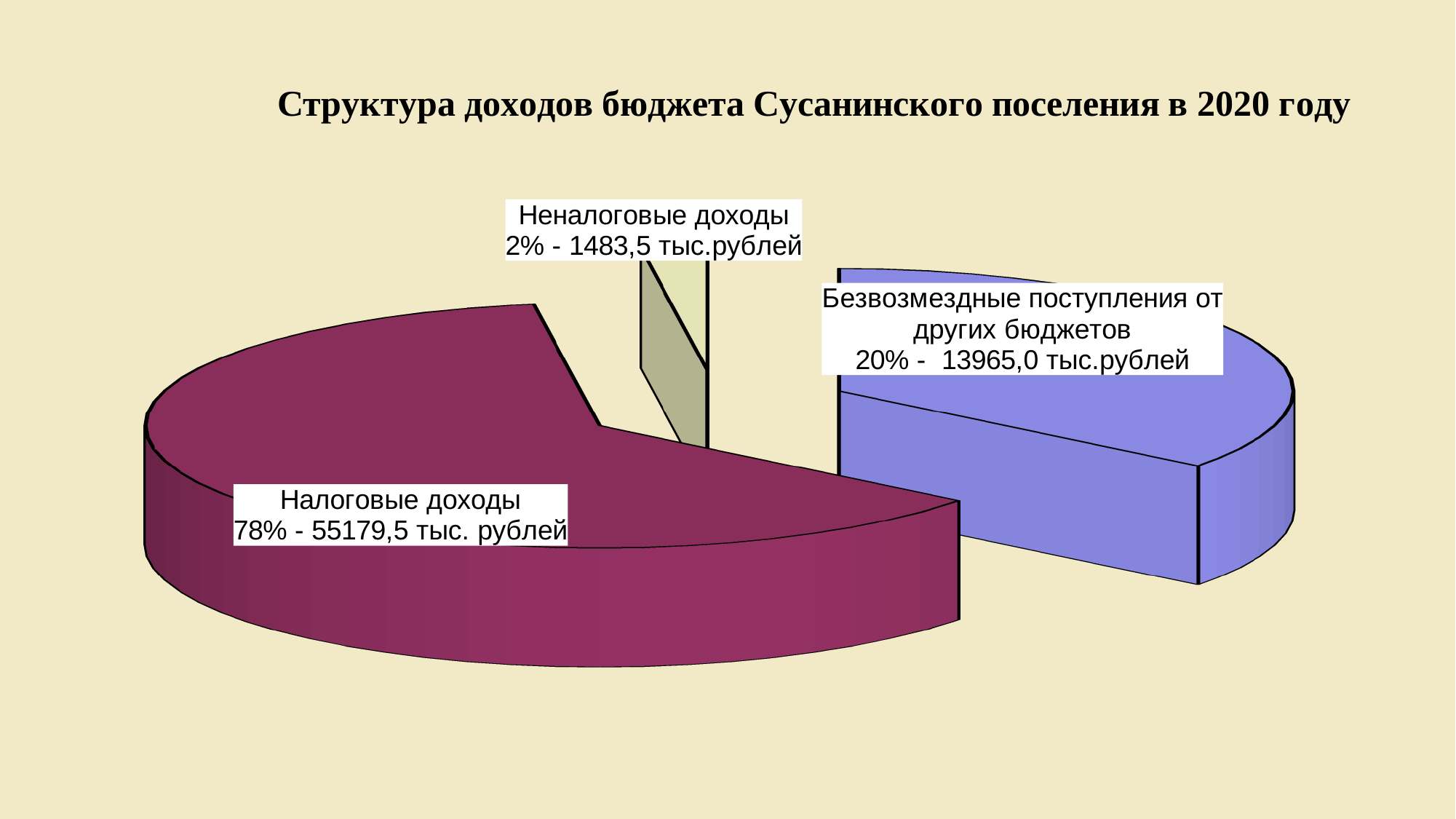
What type of chart is shown on the slide? Pie chart What share of the pie is Налоговые доходы? 78% What share of the pie is Безвозмездные поступления от других бюджетов? 20% What share of the pie is Неналоговые доходы? 2% What is the value for Налоговые доходы in thousand rubles? 55179,5 тыс. рублей How many slices does the pie chart have? 3 What is the difference in percentage points between Налоговые доходы and Безвозмездные поступления от других бюджетов? 58 What is the title of the chart? Структура доходов бюджета Сусанинского поселения в 2020 году What is the value for Неналоговые доходы in thousand rubles? 1483,5 тыс.рублей What is the value for Безвозмездные поступления от других бюджетов in thousand rubles? 13965,0 тыс.рублей Which category has the smallest share of the pie? Неналоговые доходы Which category has the largest share of the pie? Налоговые доходы